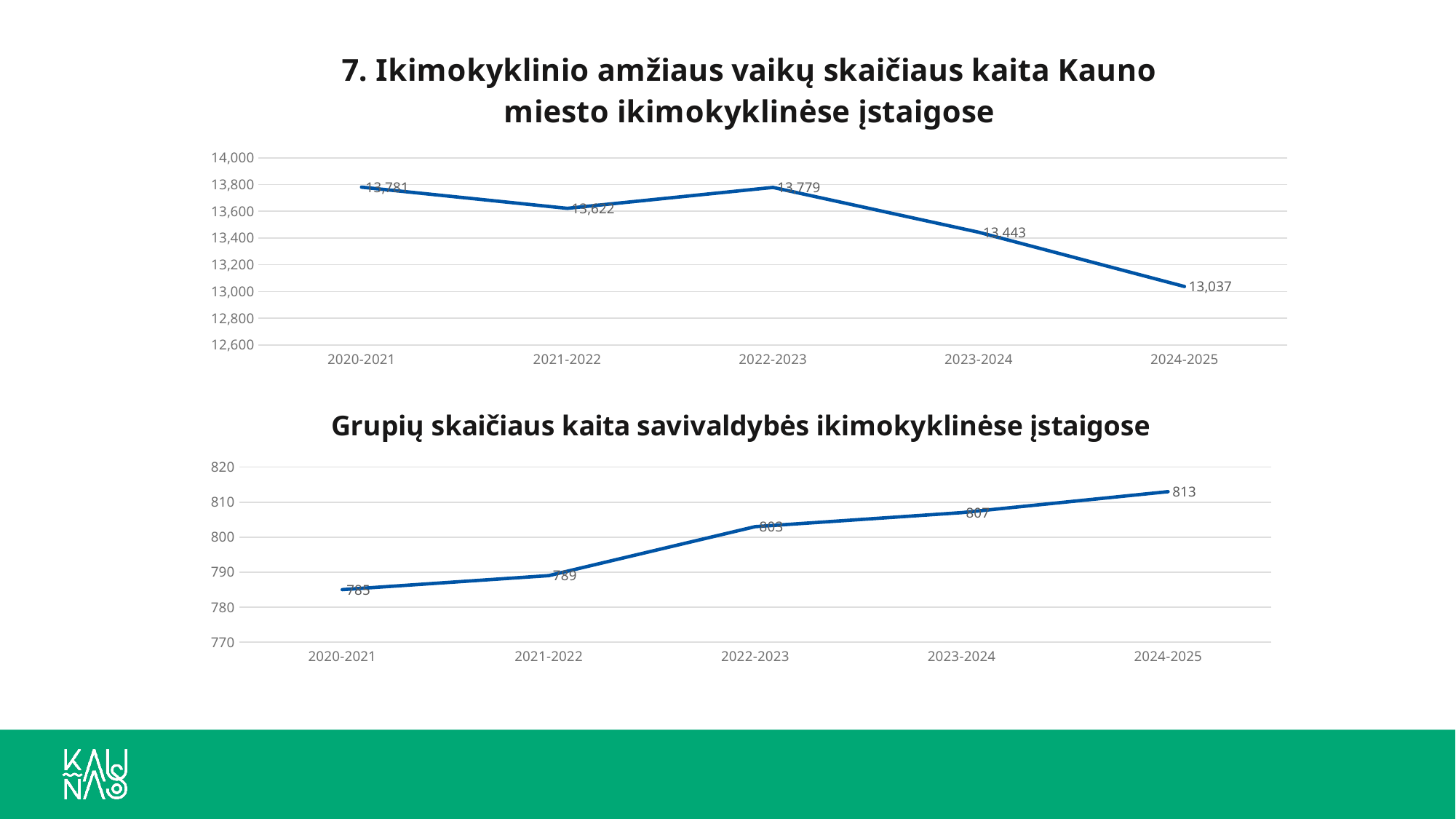
In the top chart (Ikimokyklinio amžiaus vaikų skaičiaus kaita), what is the value for 2024-2025? 13,037 In the bottom chart (Grupių skaičiaus kaita), what is the value for 2022-2023? 803 In the top chart (Ikimokyklinio amžiaus vaikų skaičiaus kaita), how many school years are plotted? 5 In the top chart (Ikimokyklinio amžiaus vaikų skaičiaus kaita), what is the value for 2021-2022? 13,622 In the top chart (Ikimokyklinio amžiaus vaikų skaičiaus kaita), which school year has the lowest value? 2024-2025 In the bottom chart (Grupių skaičiaus kaita), which school year has the highest value? 2024-2025 In the bottom chart (Grupių skaičiaus kaita), what is the difference between the 2024-2025 value and the 2020-2021 value? 28 In the top chart (Ikimokyklinio amžiaus vaikų skaičiaus kaita), what is the difference between the 2023-2024 value and the 2024-2025 value? 406 In the top chart (Ikimokyklinio amžiaus vaikų skaičiaus kaita), is the value for 2022-2023 larger or smaller than the value for 2023-2024? larger In the bottom chart (Grupių skaičiaus kaita), do the values rise or fall from 2020-2021 to 2024-2025? rise What kind of chart is the bottom chart (Grupių skaičiaus kaita)? line chart In the bottom chart (Grupių skaičiaus kaita), which school year has the lowest value? 2020-2021